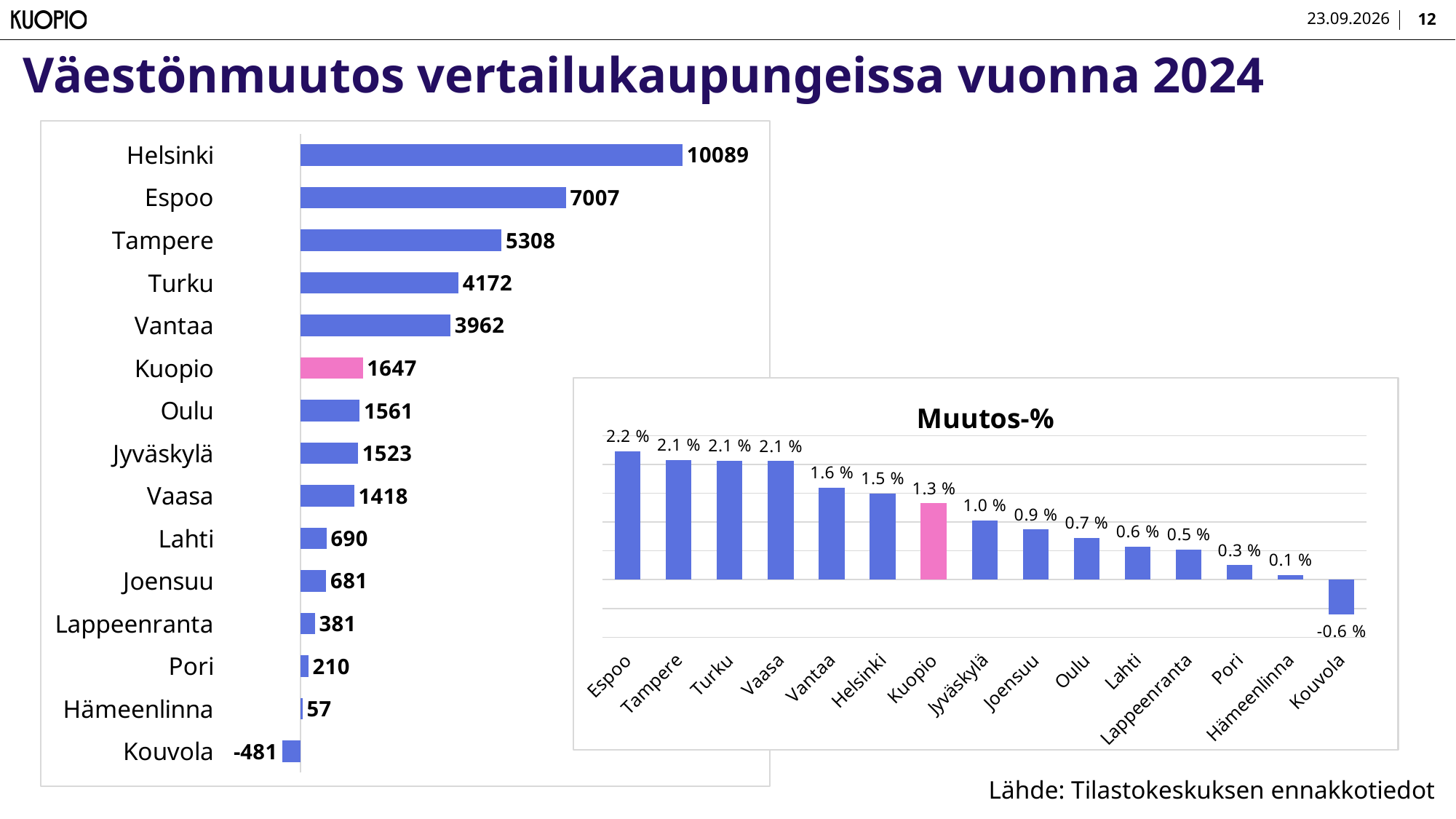
In the Muutos-% chart, what is the value for Kuopio? 1.3 % In the left-hand bar chart, what is the value for Kuopio? 1647 In the left-hand bar chart, which city has the highest value? Helsinki In the left-hand bar chart, which city's bar is coloured pink instead of blue? Kuopio In the Muutos-% chart, which city has the highest value? Espoo In the left-hand bar chart, which city has the lowest value? Kouvola In the Muutos-% chart, which is larger, the value for Vantaa or the value for Helsinki? Vantaa In the Muutos-% chart, which city has the lowest value? Kouvola What kind of chart is the Muutos-% chart? Bar chart In the left-hand bar chart, what is the value for Hämeenlinna? 57 In the left-hand bar chart, how many cities are shown? 15 In the left-hand bar chart, what is the difference between the values for Helsinki and Espoo? 3082